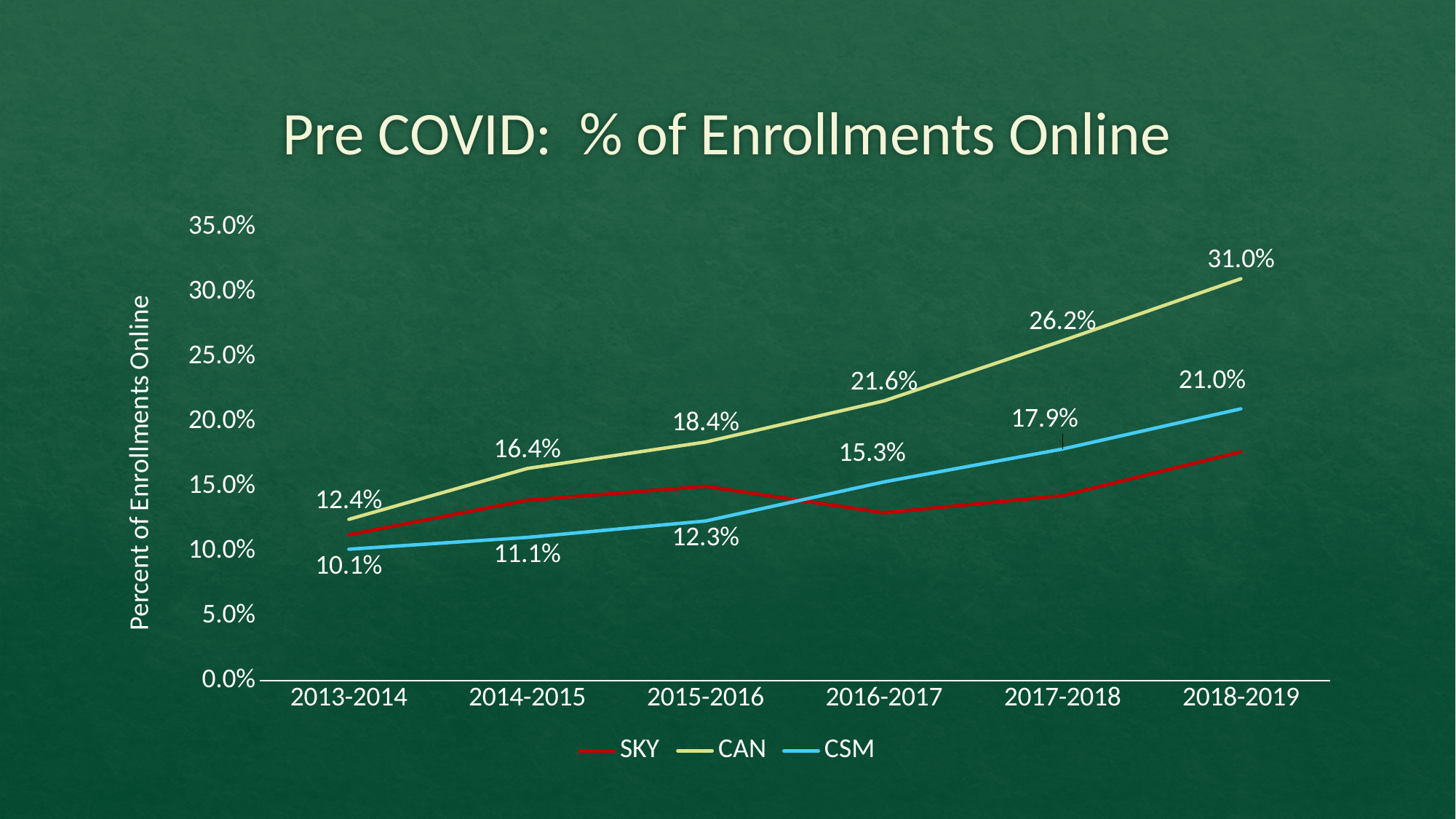
What kind of chart is shown on the slide? Line chart Which is larger in 2016-2017, CAN or CSM? CAN Is the SKY value for 2018-2019 greater or less than 15.0%? greater What is the difference between the CAN values for 2018-2019 and 2017-2018? 4.8% What is the CSM value for 2013-2014? 10.1% In which year is the CSM value lowest? 2013-2014 What is the CAN value for 2015-2016? 18.4% How many series does the legend list? 3 How many academic years are shown on the x axis? 6 What is the CSM value for 2017-2018? 17.9% In which year is the CAN value highest? 2018-2019 What is the CAN value for 2018-2019? 31.0%